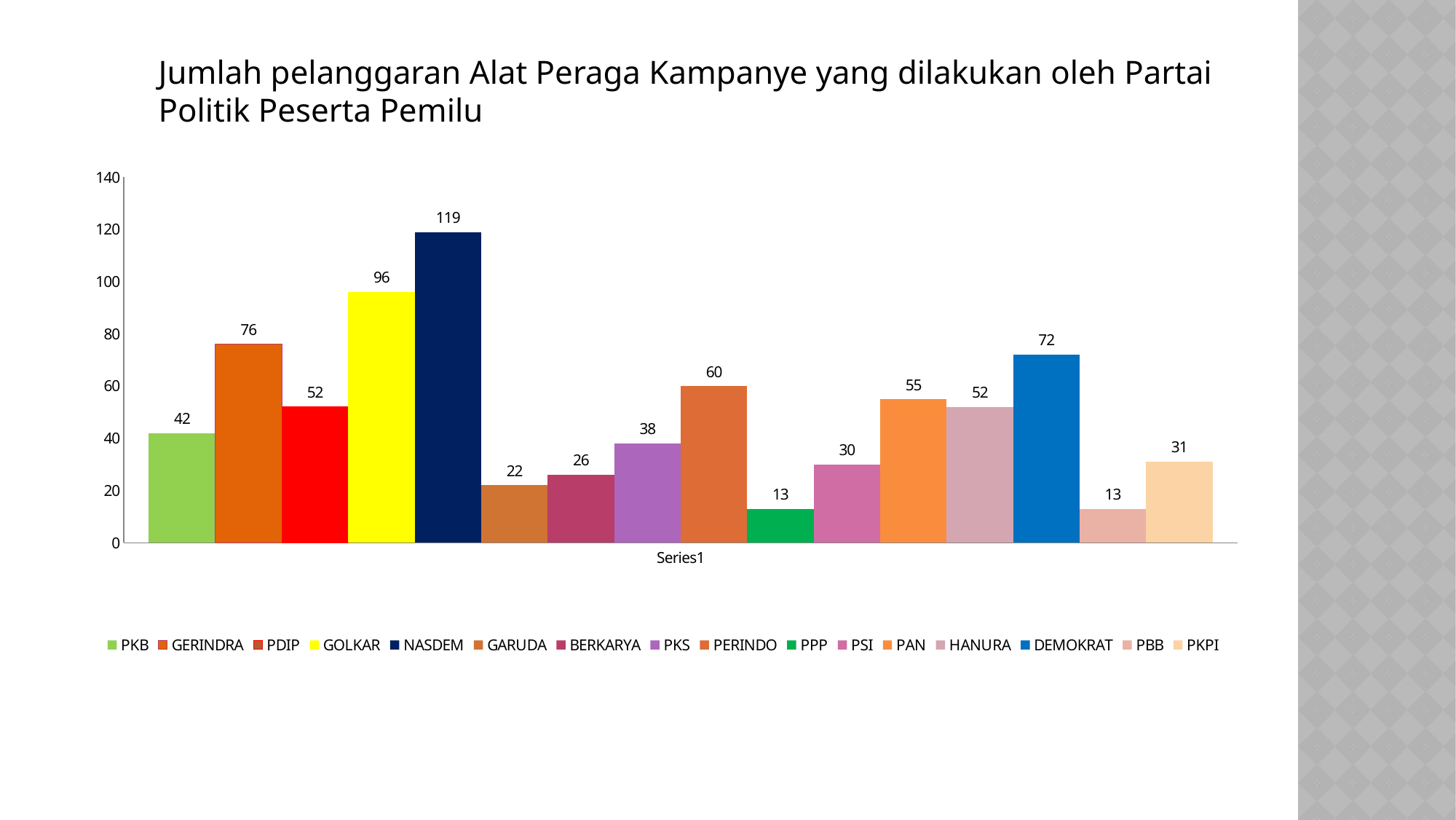
What is the value for PERINDO? 60 Is the value for GOLKAR greater or less than 100? less What is the difference between the values for DEMOKRAT and PAN? 17 How many entries does the legend list? 16 Which is larger, the value for PKS or the value for PSI? PKS What is the value for PKPI? 31 What kind of chart is shown on the slide? bar chart How many bars are plotted in the chart? 16 What is the difference between the values for GOLKAR and PDIP? 44 What is the value for NASDEM? 119 Which party has the highest value? NASDEM What is the value for GERINDRA? 76